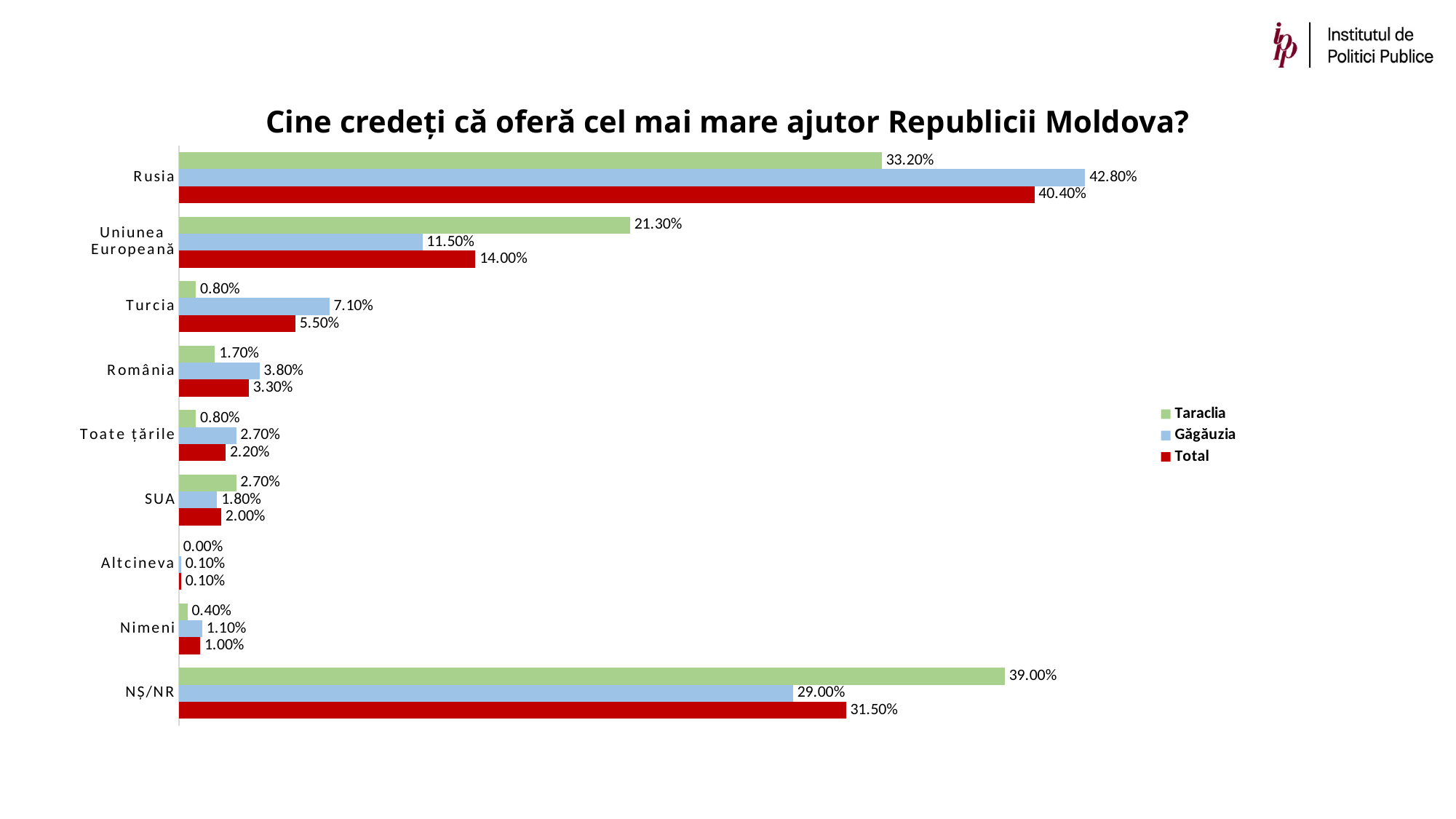
Which series is shown in red? Total What is the Găgăuzia value for Turcia? 7.10% Which is larger for SUA: the Taraclia value or the Găgăuzia value? Taraclia What kind of chart is shown on the slide? Bar chart What is the Total value for NȘ/NR? 31.50% How many categories are shown on the chart? 9 What is the difference between the Găgăuzia and Taraclia values for Rusia? 9.60% What is the Taraclia value for Uniunea Europeană? 21.30% How many series does the legend list? 3 Which category has the lowest Total value? Altcineva Which category has the highest Găgăuzia value? Rusia What is the Găgăuzia value for Rusia? 42.80%